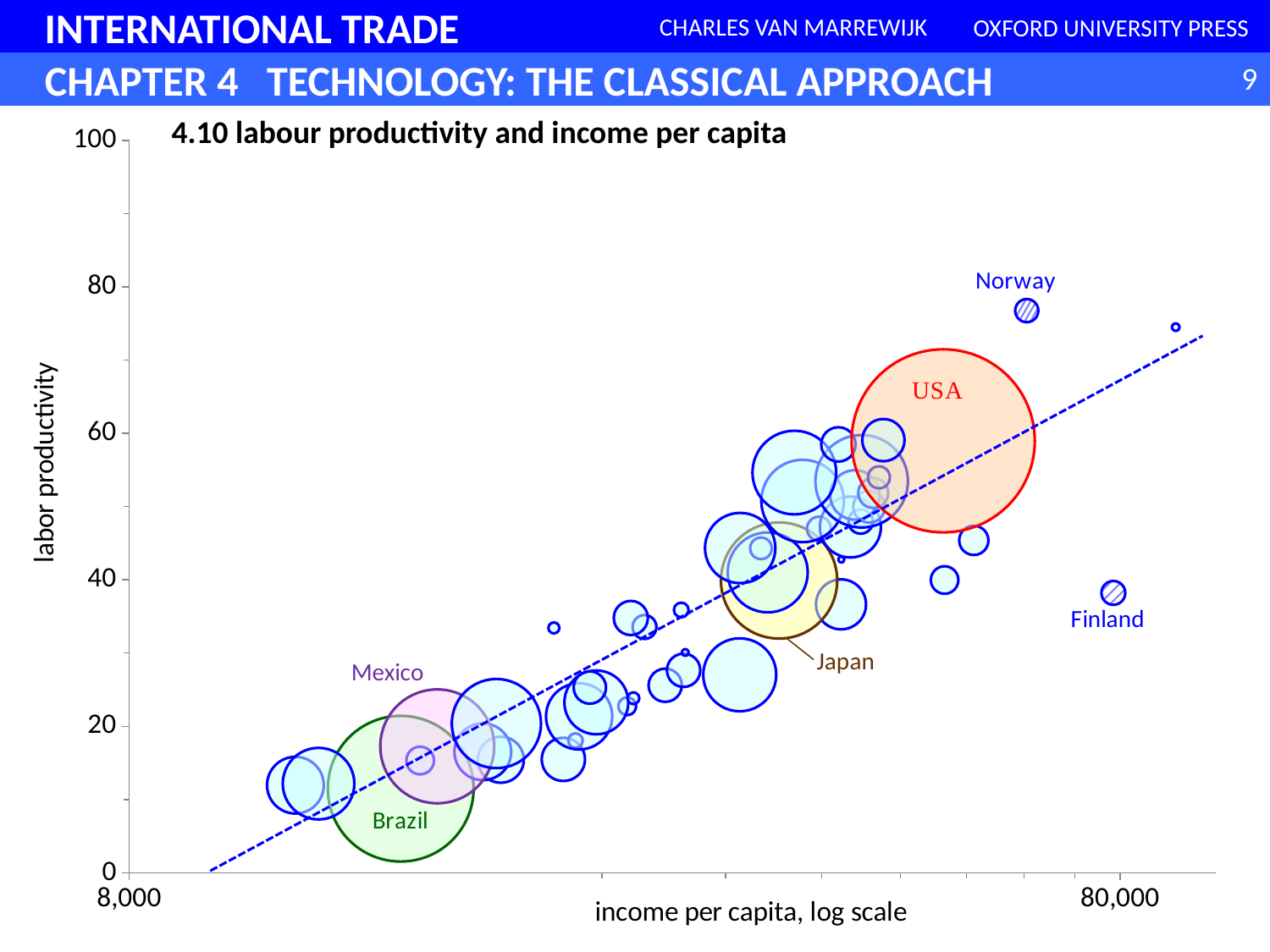
Is the labor productivity value for Finland greater or less than 60? less What is the title of the chart? 4.10 labour productivity and income per capita Is the labor productivity value for Norway greater or less than 60? greater Among the labelled countries, which has the highest labor productivity? Norway What kind of chart is shown on the slide? bubble chart Is the labor productivity value for USA greater or less than 40? greater Which has the higher labor productivity, Norway or Finland? Norway What is the label of the vertical axis? labor productivity Does labor productivity generally rise or fall as income per capita increases along the x axis? rise Which has the higher labor productivity, USA or Brazil? USA